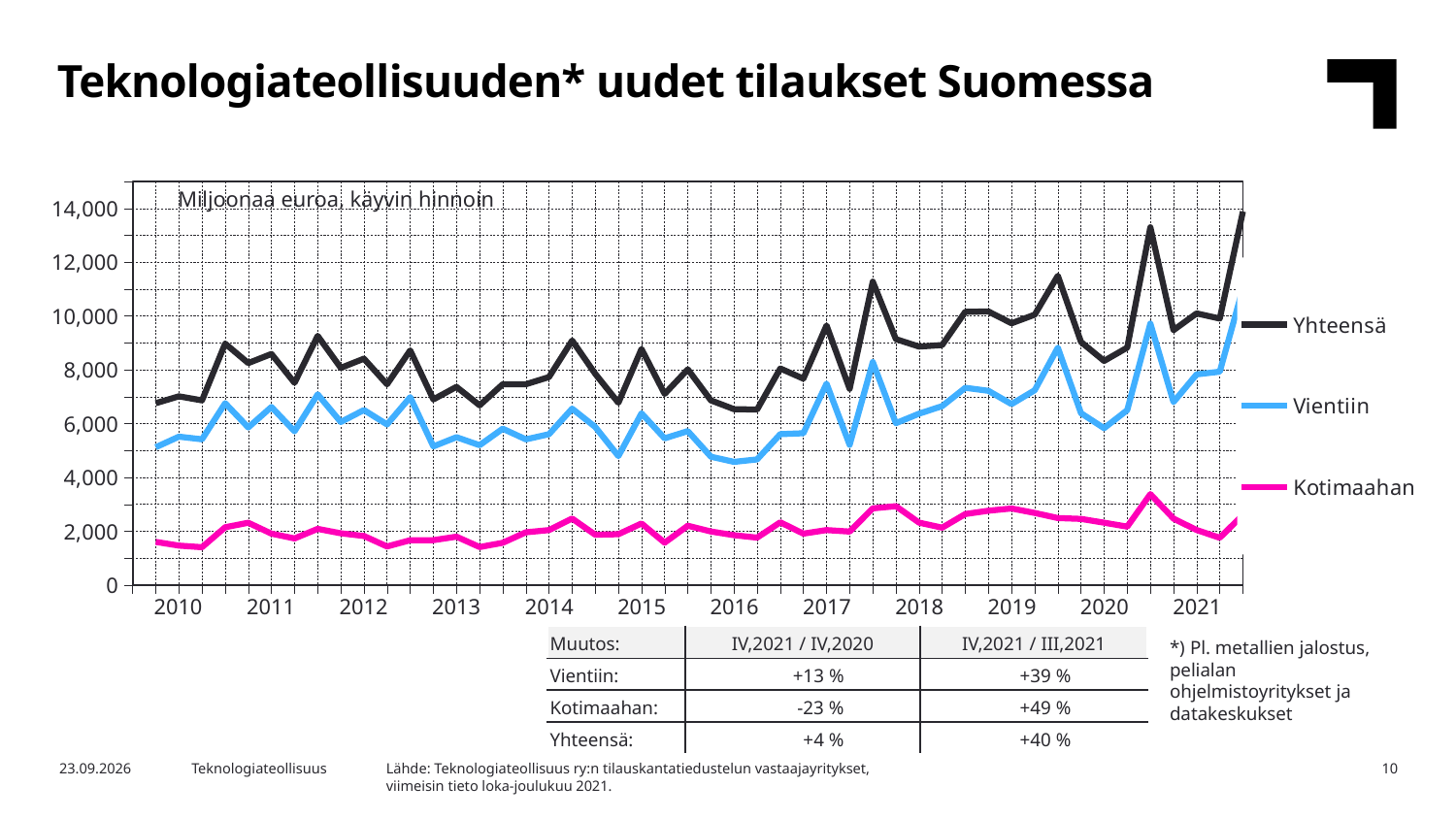
Is the value for Kotimaahan at the last point in 2021 greater or less than 4,000? less What is the title of the chart on the slide? Teknologiateollisuuden* uudet tilaukset Suomessa Is the lowest value for Vientiin in 2016 greater or less than 6,000? less Which series has the highest values throughout the whole period shown? Yhteensä How many years are labelled on the x axis of the chart? 12 Does the Yhteensä series generally rise or fall from 2016 to the end of 2021? Rise What kind of chart is shown on the slide? Line chart How many series does the chart legend list? 3 What are the three series named in the chart legend? Yhteensä, Vientiin, Kotimaahan Which series has the lowest values throughout the whole period shown? Kotimaahan At the last point in 2021, which is larger, Vientiin or Kotimaahan? Vientiin Is the value for Yhteensä at the last point in 2021 greater or less than 12,000? greater